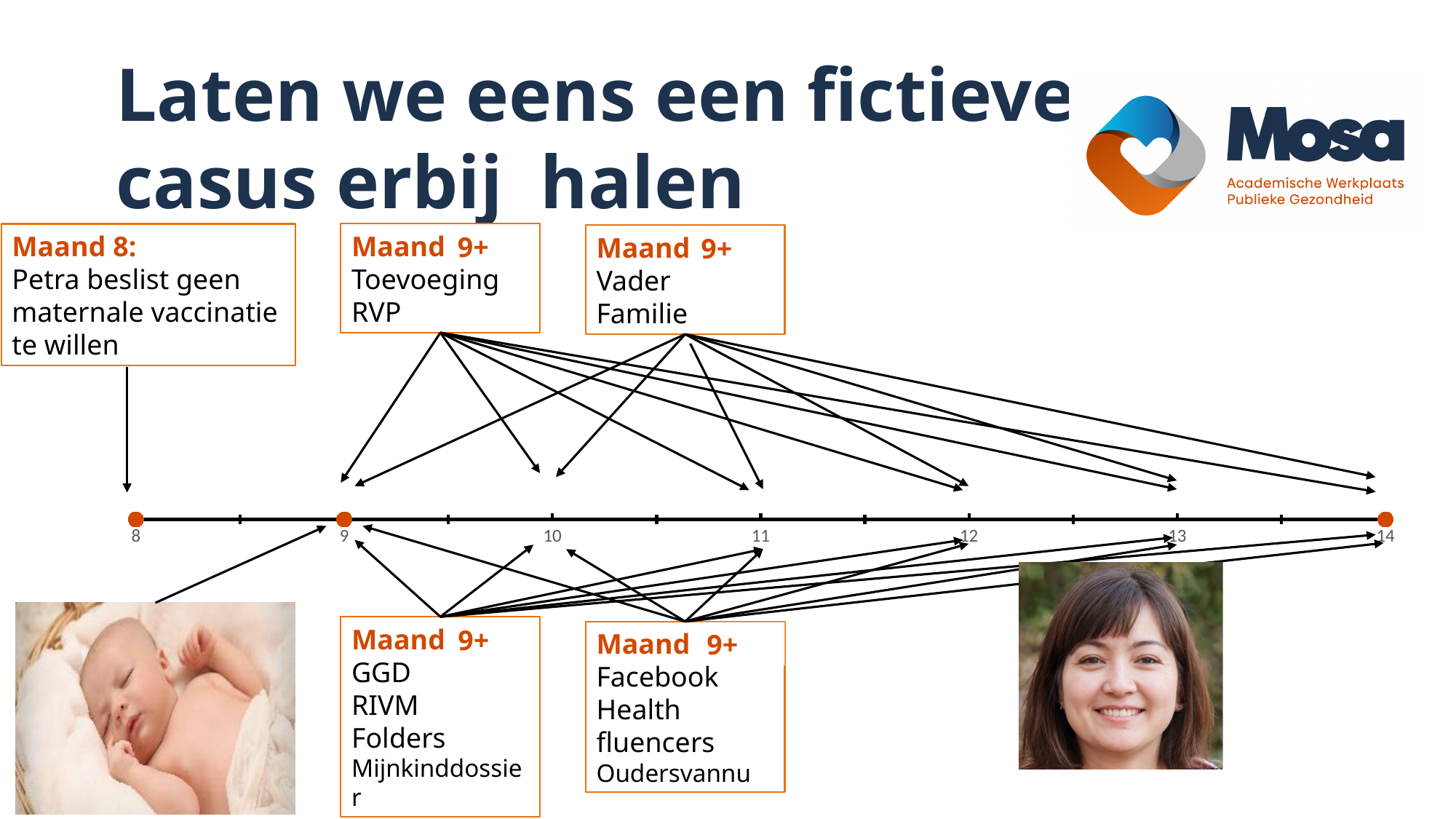
What is the last month labeled on the timeline axis? 14 Is the month marked by the 'Maand 8' box earlier or later on the timeline than month 9? Earlier At which months are the orange dots placed on the timeline? 8, 9 and 14 What is the title of the slide? Laten we eens een fictieve casus erbij halen How many orange dots are placed on the timeline? 3 What kind of diagram is shown on the slide? A timeline How many month labels appear along the timeline axis? 7 What is the first month labeled on the timeline axis? 8 Which month on the timeline does the box 'Petra beslist geen maternale vaccinatie te willen' point to? 8 How many annotation boxes are labeled 'Maand 9+'? 4 Which items are listed in the 'Maand 9+' box that starts with GGD? GGD, RIVM, Folders, Mijnkinddossier